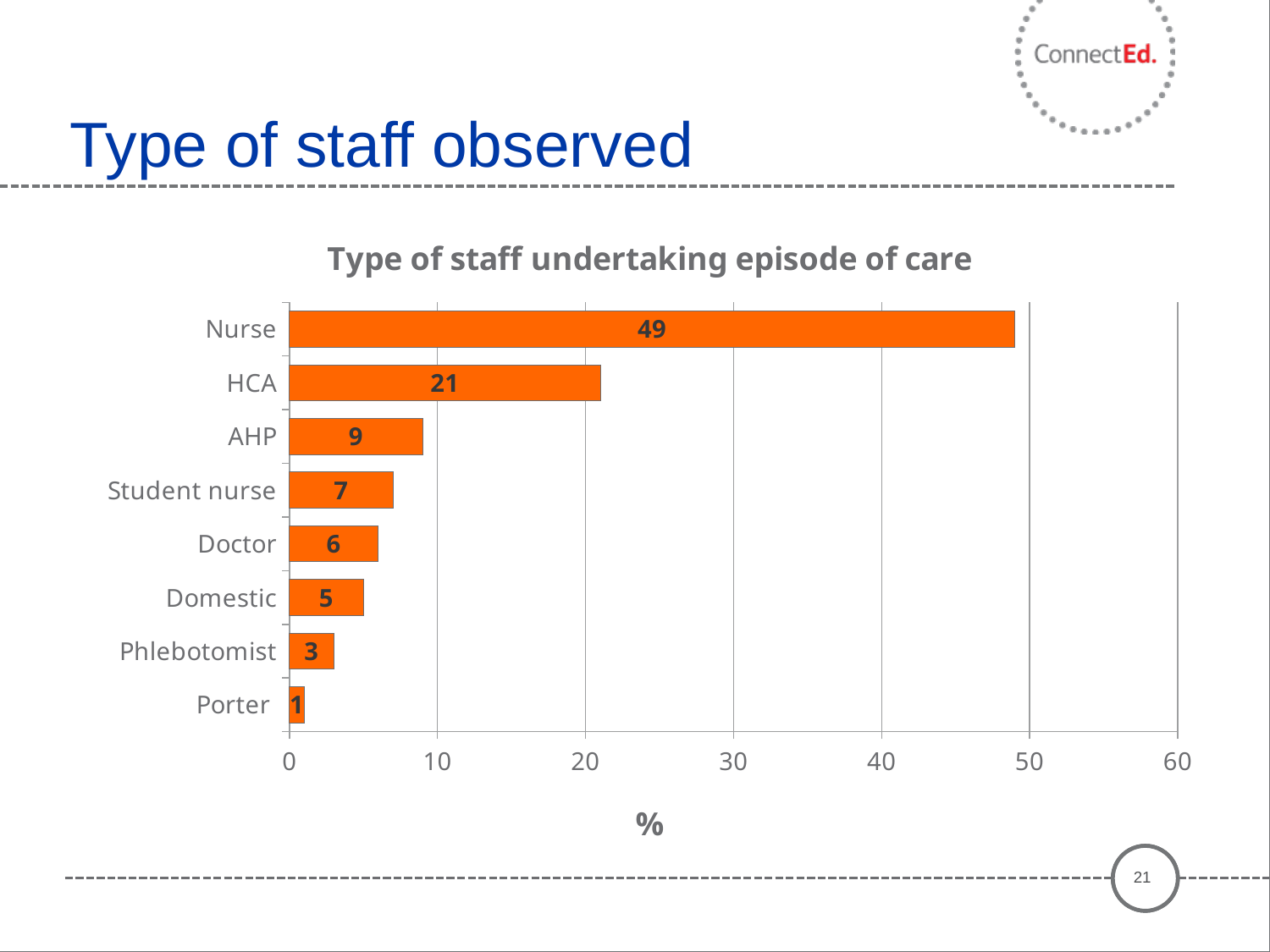
What is the value for Student nurse? 7 What is the difference between the values for Nurse and HCA? 28 How many types of staff are shown in the chart? 8 What is the value for HCA? 21 Which type of staff has the lowest value? Porter What is the value for Nurse? 49 What kind of chart is shown on the slide? Bar chart Is the value for HCA greater or less than 20? greater What is the value for Phlebotomist? 3 What is the title of the chart? Type of staff undertaking episode of care Which type of staff has the highest value? Nurse Which is larger, the value for AHP or the value for Doctor? AHP